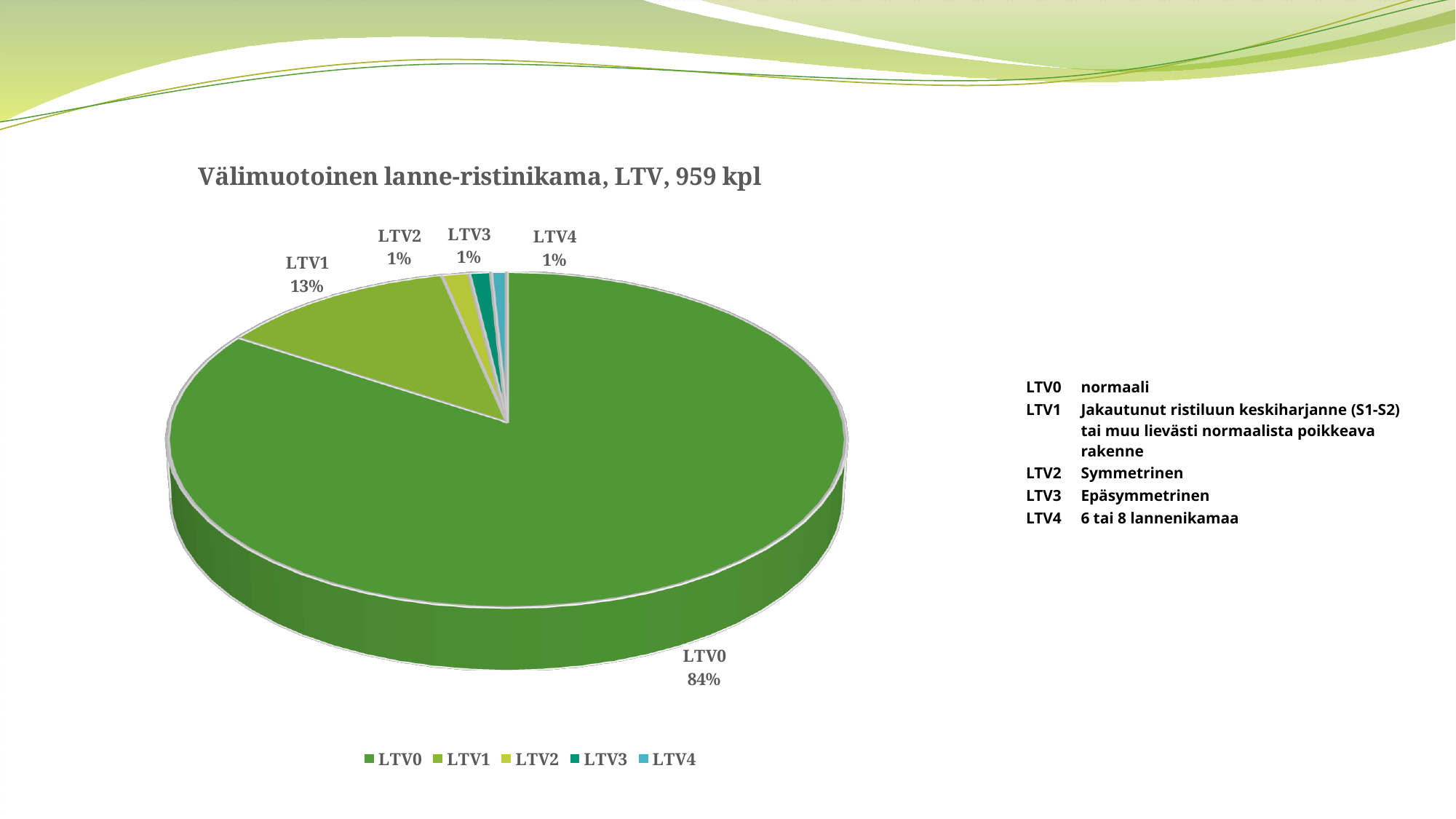
Which category has the largest slice of the pie? LTV0 What kind of chart is shown on the slide? Pie chart What share of the pie does LTV0 represent? 84% What is the difference in percentage points between LTV0 and LTV1? 71 What is the title of the chart? Välimuotoinen lanne-ristinikama, LTV, 959 kpl What share of the pie does LTV1 represent? 13% How many slices does the pie chart have? 5 Which is larger, the share for LTV1 or the share for LTV3? LTV1 What is the combined share of LTV2, LTV3 and LTV4? 3% How many categories does the legend list? 5 What percentage is shown for LTV2? 1% What percentage is shown for LTV4? 1%